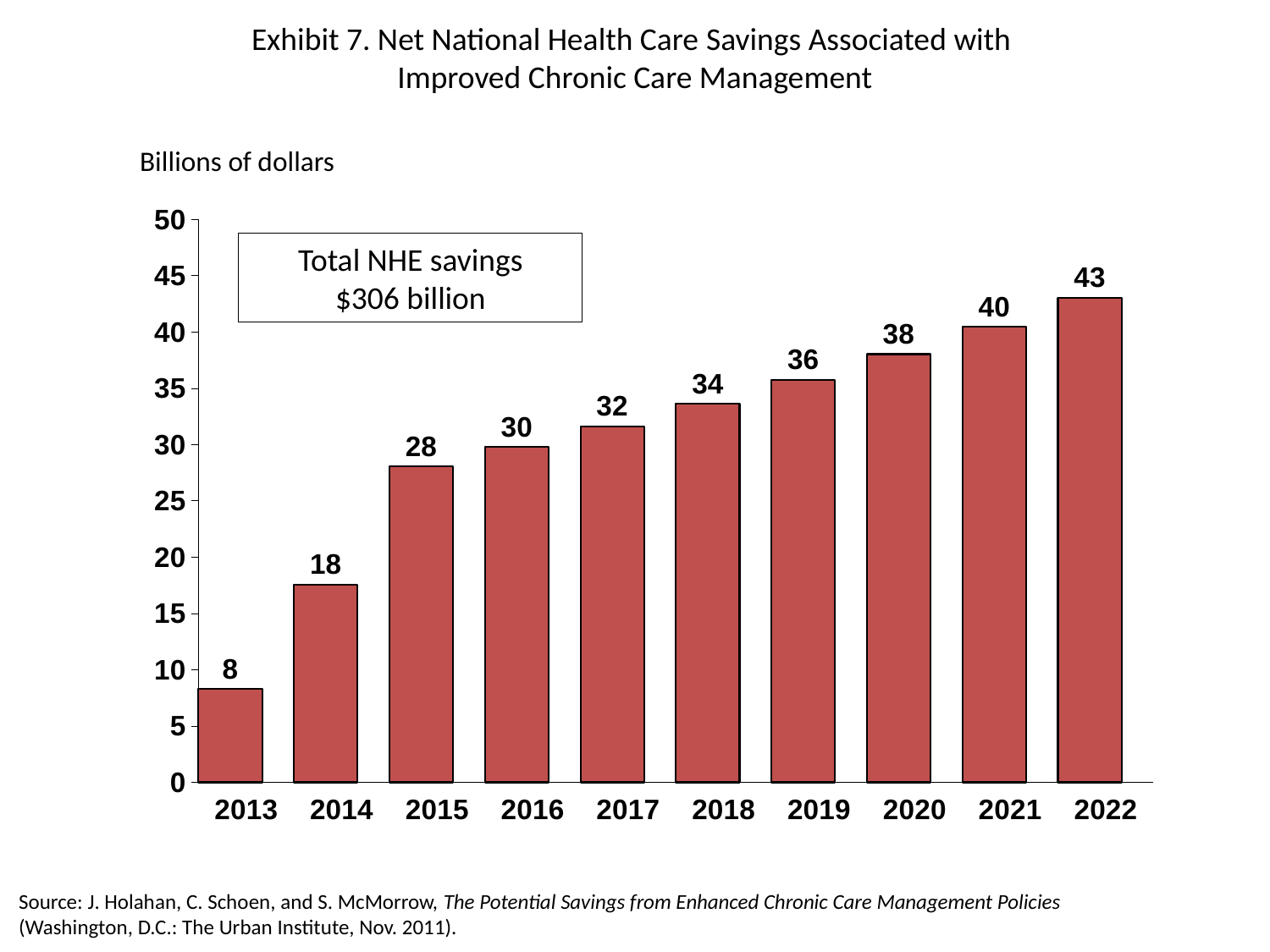
What is the difference between the values for 2022 and 2013? 35 What kind of chart is shown? bar chart How many years are shown on the x axis? 10 What is the value for 2020? 38 What total NHE savings figure is shown in the box on the chart? $306 billion Which year has the highest value? 2022 Which year has the lowest value? 2013 What is the value for 2015? 28 Which is larger, the value for 2017 or the value for 2019? 2019 Is the value for 2021 greater or less than 35? greater Do the values rise or fall from 2013 to 2022? rise What is the difference between the values for 2015 and 2014? 10